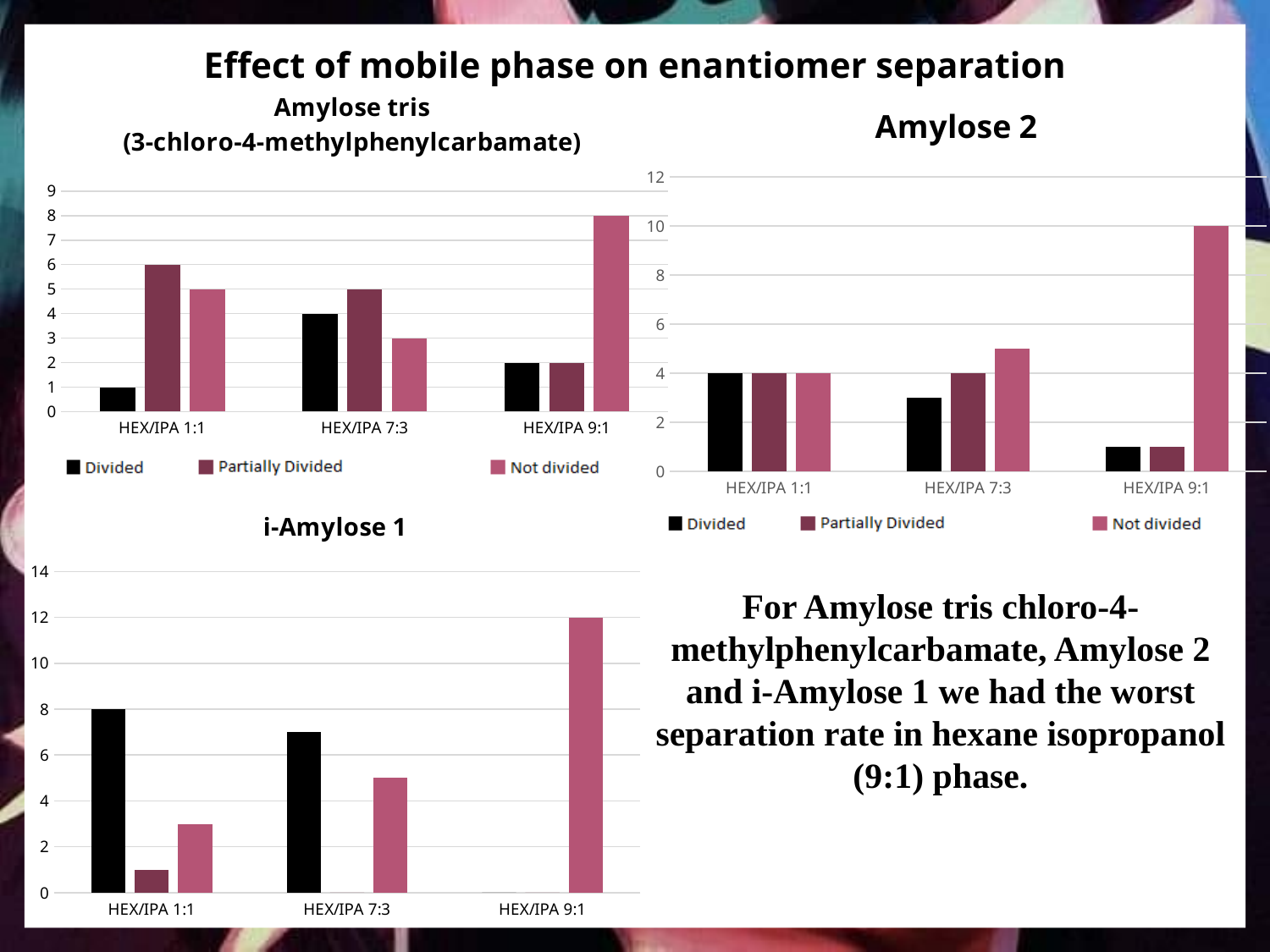
In the Amylose 2 chart, what is the value of Not divided for HEX/IPA 9:1? 10 In the Amylose tris (3-chloro-4-methylphenylcarbamate) chart, what is the difference between Partially Divided and Divided for HEX/IPA 1:1? 5 In the Amylose 2 chart, is the Not divided value for HEX/IPA 7:3 greater or less than 4? greater What kind of chart is the i-Amylose 1 chart? bar chart How many series does the legend of the Amylose tris (3-chloro-4-methylphenylcarbamate) chart list? 3 In the i-Amylose 1 chart, does the pink (Not divided) series rise or fall from HEX/IPA 1:1 to HEX/IPA 9:1? rise In the i-Amylose 1 chart, which mobile phase has the tallest bar? HEX/IPA 9:1 In the Amylose 2 chart, which has the larger Divided value, HEX/IPA 1:1 or HEX/IPA 7:3? HEX/IPA 1:1 In the i-Amylose 1 chart, what is the value of the black (Divided) bar for HEX/IPA 1:1? 8 In the Amylose tris (3-chloro-4-methylphenylcarbamate) chart, what is the value of Not divided for HEX/IPA 9:1? 8 In the Amylose tris (3-chloro-4-methylphenylcarbamate) chart, which mobile phase has the highest Not divided value? HEX/IPA 9:1 In the Amylose tris (3-chloro-4-methylphenylcarbamate) chart, what is the value of Partially Divided for HEX/IPA 1:1? 6